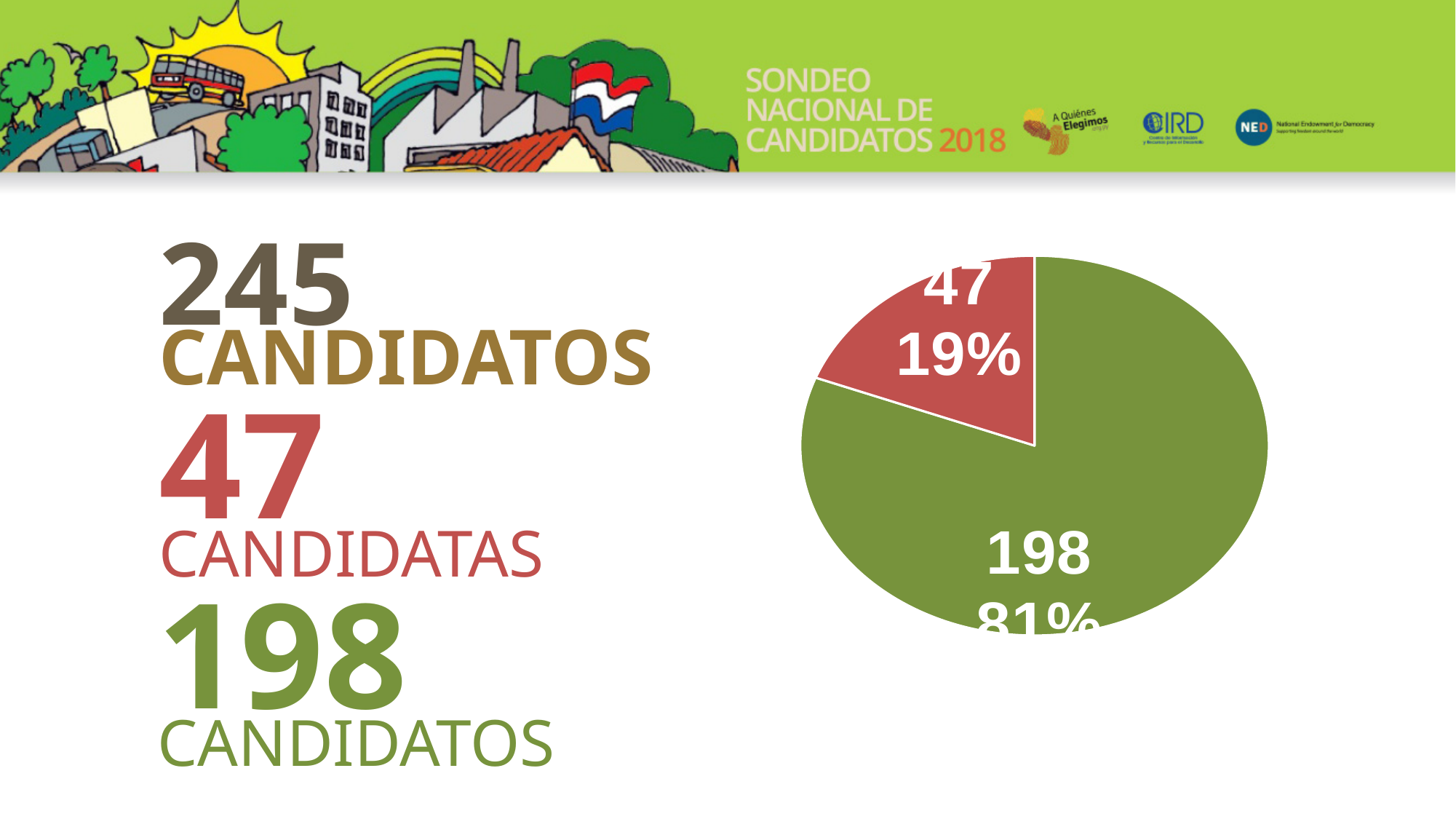
Is the value of the green slice larger or smaller than the value of the red slice? larger What is the difference between the values of the green slice and the red slice in the pie chart? 151 Which slice of the pie chart is the largest? the green slice (198, 81%) What value is printed on the red slice of the pie chart? 47 What percentage share is shown for the green slice of the pie chart? 81% What is the total of the two slice values in the pie chart? 245 What value is printed on the green slice of the pie chart? 198 Which colour is used for the slice representing the 47 candidatas? red Which slice of the pie chart is the smallest? the red slice (47, 19%) What percentage share is shown for the red slice of the pie chart? 19% What kind of chart is shown on the slide? pie chart How many slices does the pie chart have? 2